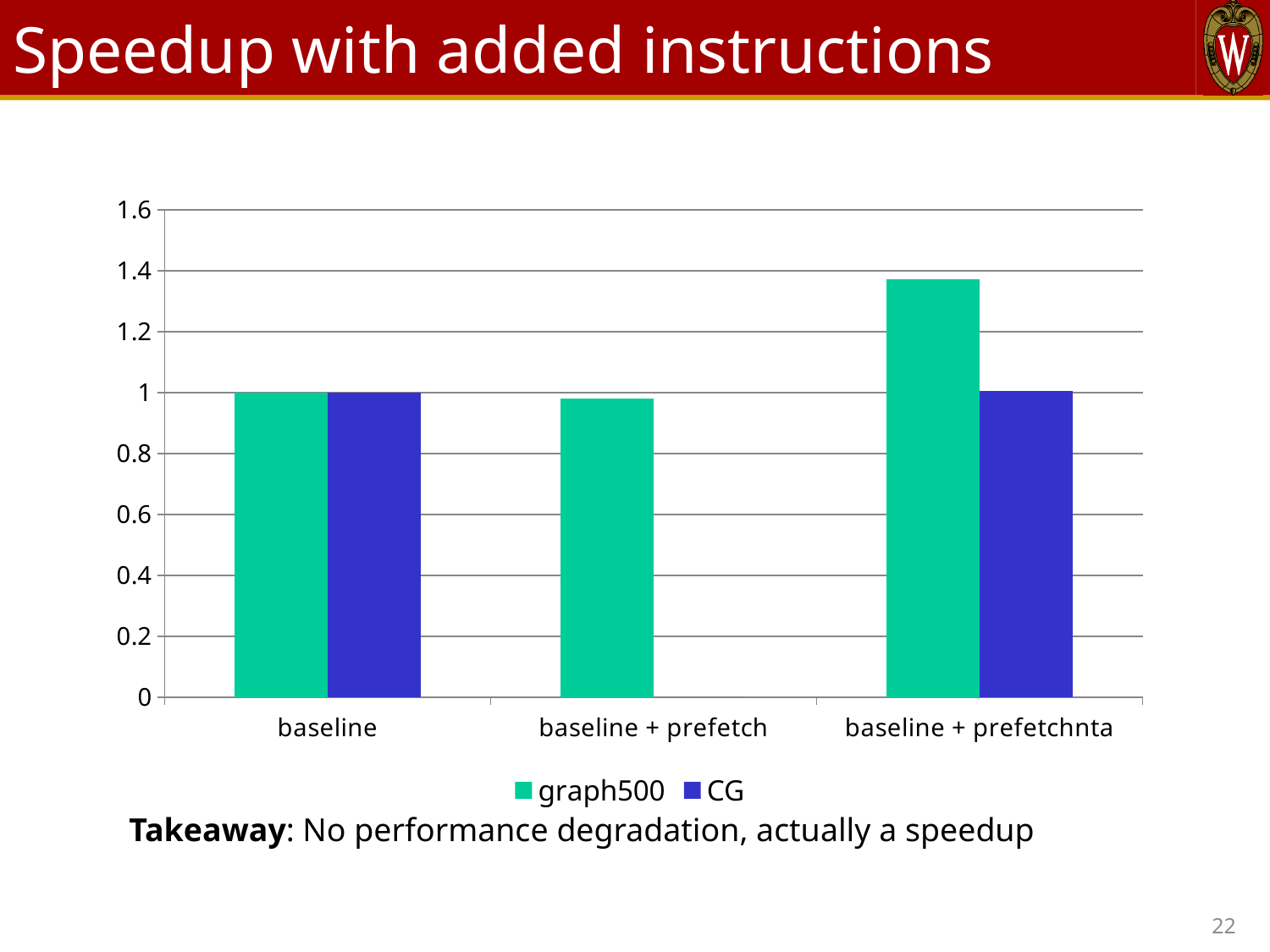
What is the CG value for baseline? 1 How many series does the legend list? 2 Is the graph500 value for baseline + prefetch greater or less than 1.2? less What is the title of the slide containing the chart? Speedup with added instructions Is the graph500 value for baseline + prefetchnta greater or less than 1.2? greater What are the two series named in the legend? graph500 and CG What is the graph500 value for baseline? 1 Which category has the highest graph500 value? baseline + prefetchnta How many categories are shown on the x axis? 3 How many bars are shown for the baseline + prefetch category? 1 Which is larger, the graph500 value for baseline or for baseline + prefetchnta? baseline + prefetchnta What kind of chart is shown on the slide? bar chart